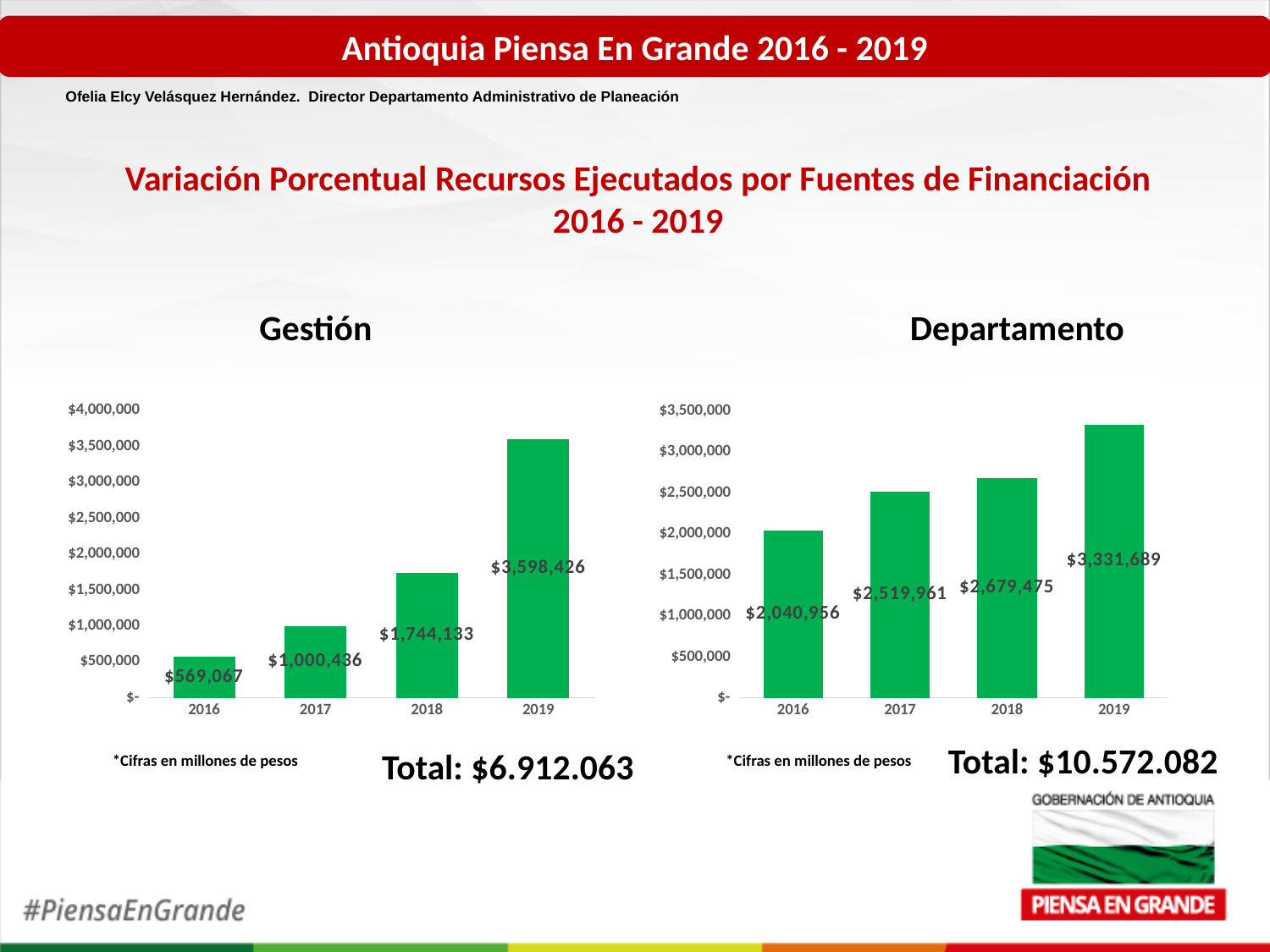
In the Gestión chart, which year has the lowest value? 2016 In the Gestión chart, do the values rise or fall from 2016 to 2019? rise In the Departamento chart, is the value for 2018 greater or less than $2,500,000? greater In the Departamento chart, which year has the highest value? 2019 What kind of chart is the Departamento chart? bar chart In the Gestión chart, what is the value for 2016? $569,067 In the Departamento chart, what is the value for 2017? $2,519,961 How many years are shown in the Gestión chart? 4 In the Gestión chart, what is the difference between the 2019 and 2018 values? $1,854,293 In the Departamento chart, what is the difference between the 2019 and 2016 values? $1,290,733 In the Gestión chart, what is the value for 2018? $1,744,133 Which is larger: the 2016 value in the Gestión chart or the 2016 value in the Departamento chart? Departamento